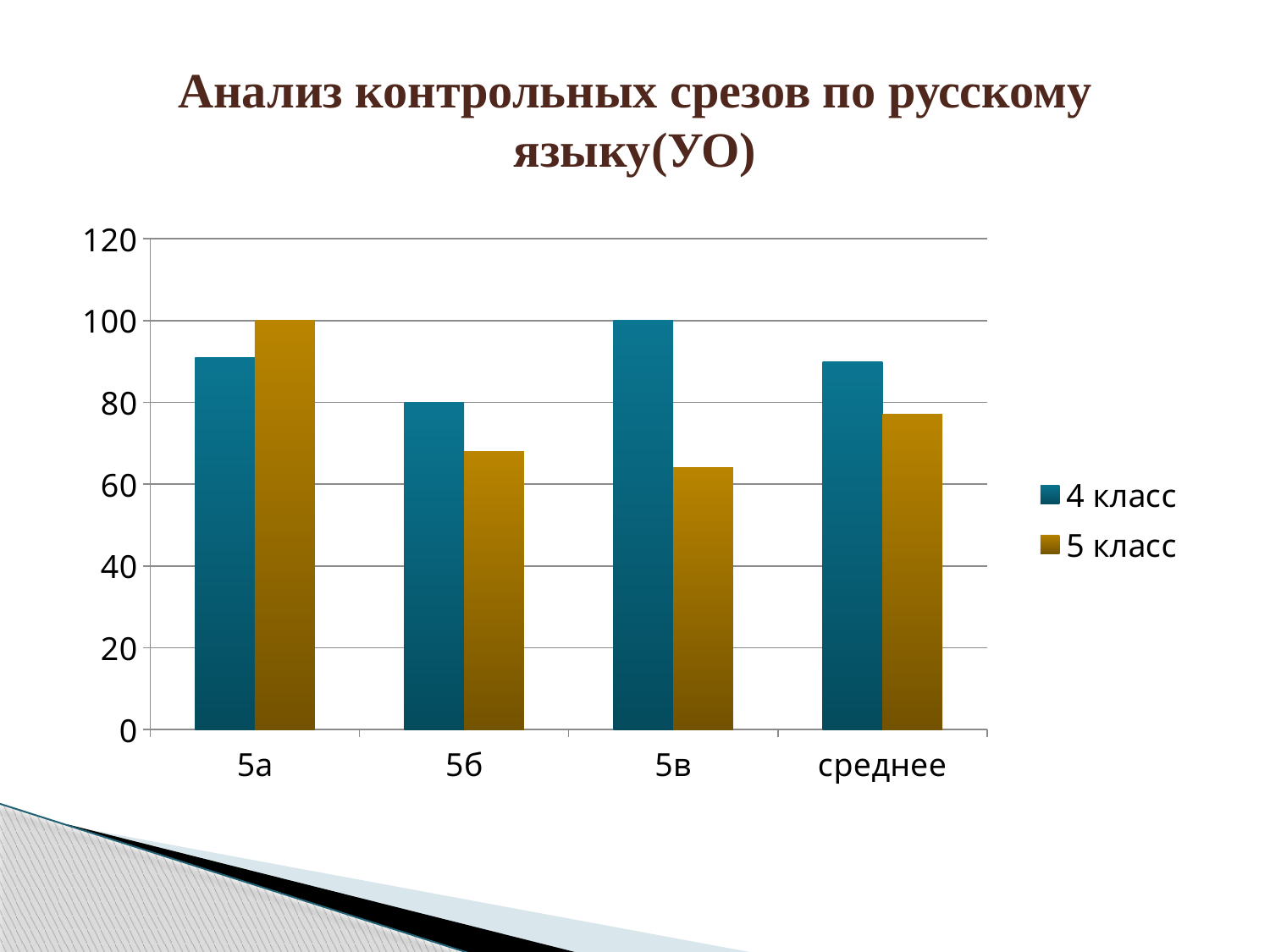
What type of chart is shown on the slide? bar chart What is the value for 4 класс in category 5в? 100 What is the value for 5 класс in category 5а? 100 How many series does the legend list? 2 Is the value for 5 класс in category 5в greater or less than 80? less In category 5в, which series has the larger value, 4 класс or 5 класс? 4 класс Which category has the lowest value for 4 класс? 5б How many categories are shown on the x axis? 4 Which category has the highest value for 4 класс? 5в What is the value for 4 класс in category 5б? 80 Is the value for 5 класс in category 5б greater or less than 60? greater Is the value for 4 класс in category среднее greater or less than 80? greater